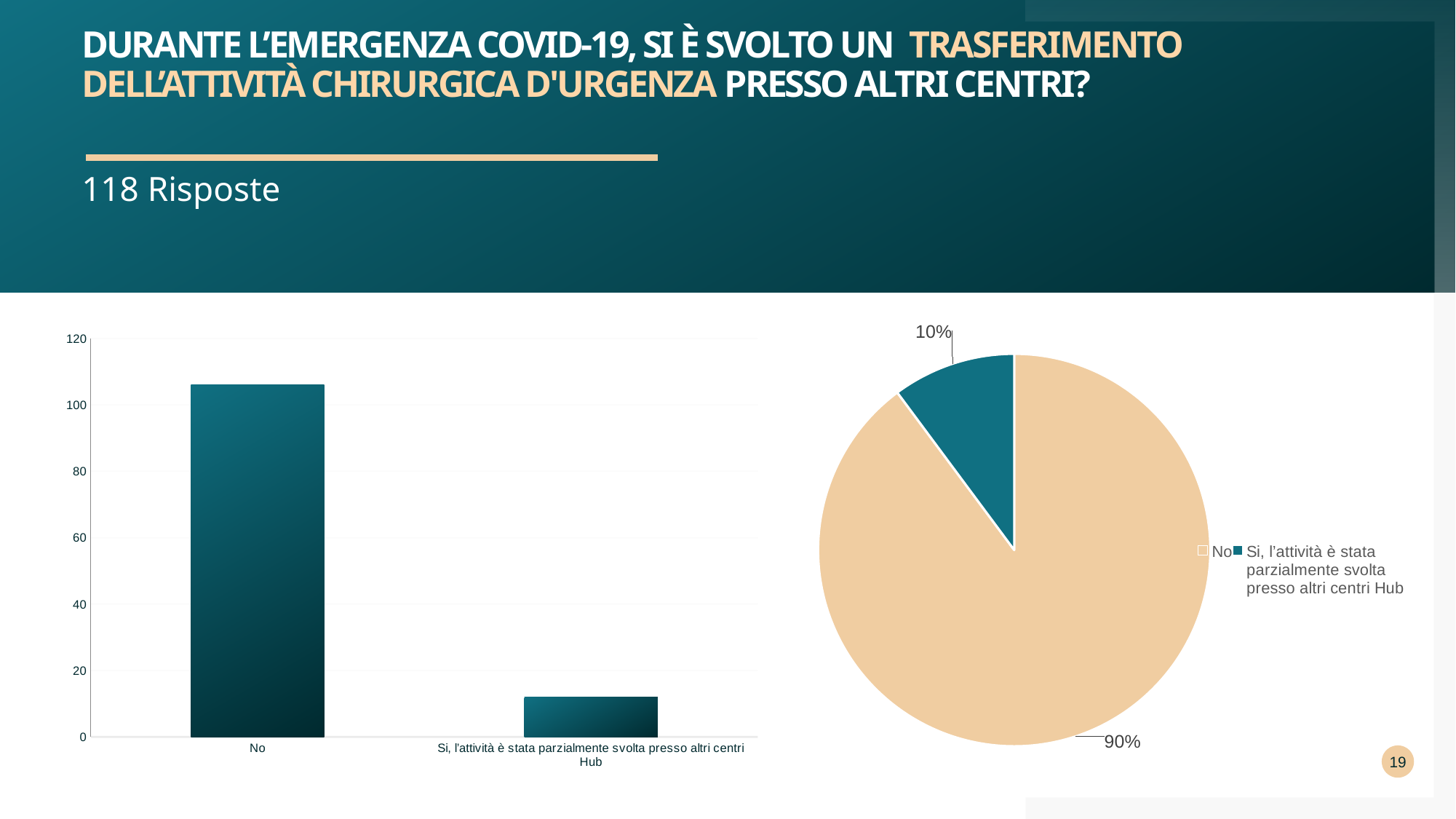
In the bar chart on the left, what is the highest value shown on the vertical axis? 120 In the bar chart on the left, is the value for 'Si, l'attività è stata parzialmente svolta presso altri centri Hub' greater or less than 20? less In the bar chart on the left, which category has the highest bar? No What kind of chart is the chart on the left of the slide? bar chart In the pie chart on the right, what share of the pie is the slice for 'Si, l'attività è stata parzialmente svolta presso altri centri Hub'? 10% In the pie chart on the right, what share of the pie is the No slice? 90% In the bar chart on the left, which is larger: the bar for No or the bar for 'Si, l'attività è stata parzialmente svolta presso altri centri Hub'? No In the bar chart on the left, how many categories are shown? 2 In the pie chart on the right, how many entries does the legend list? 2 What kind of chart is the chart on the right of the slide? pie chart In the bar chart on the left, which category has the lowest bar? Si, l'attività è stata parzialmente svolta presso altri centri Hub In the bar chart on the left, is the value for No greater or less than 100? greater